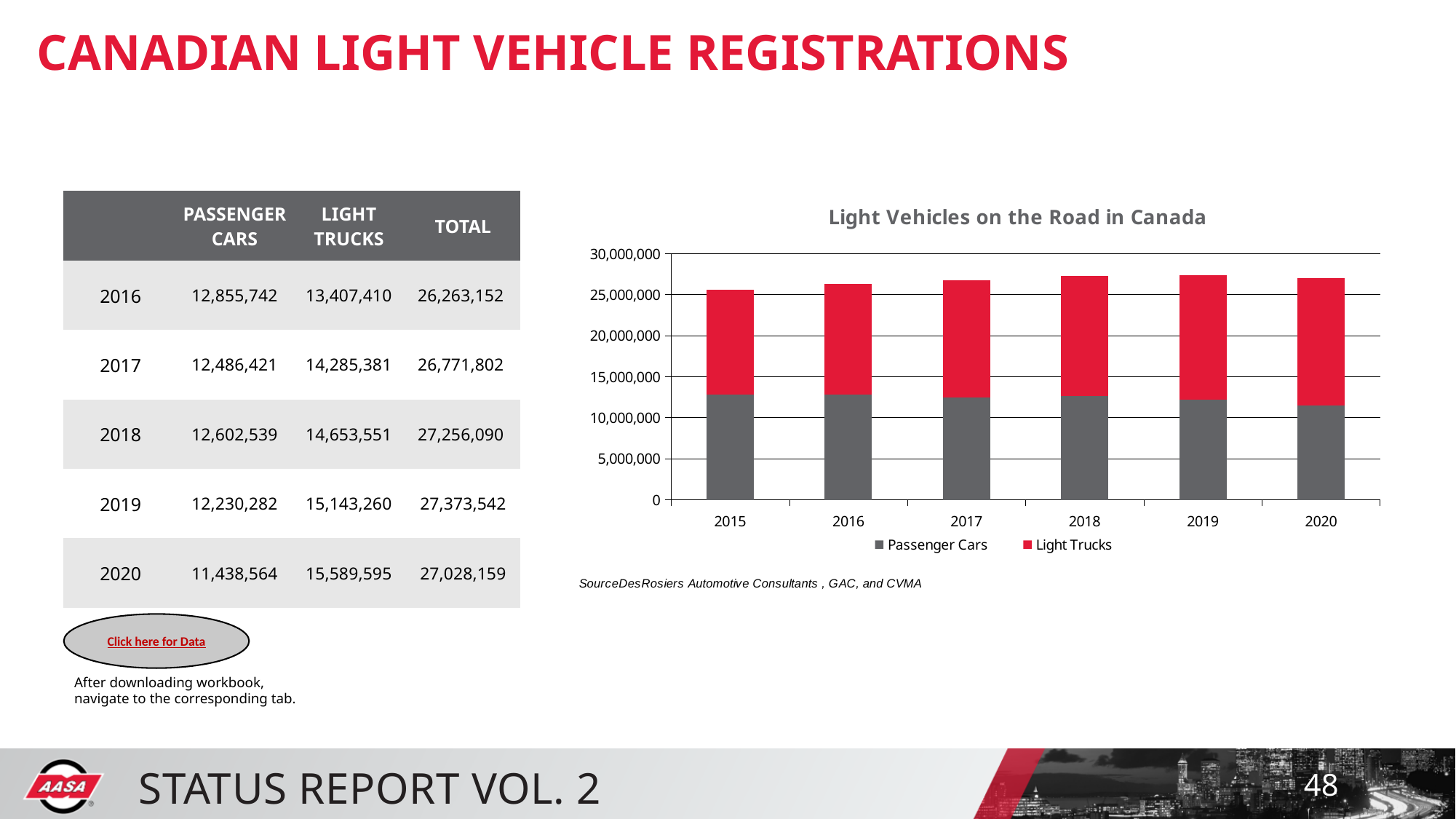
Do the Light Trucks values rise or fall from 2015 to 2020? rise What is the title of the chart on the slide? Light Vehicles on the Road in Canada Which colour represents Light Trucks in the chart? red In the chart, is the Passenger Cars value for 2020 greater or less than 10,000,000? greater How many series does the legend of the "Light Vehicles on the Road in Canada" chart list? 2 In the chart, is the Passenger Cars value for 2015 greater or less than 15,000,000? less How many years are shown on the x axis of the "Light Vehicles on the Road in Canada" chart? 6 Do the Passenger Cars values rise or fall from 2016 to 2020? fall According to the slide, what is the Light Trucks value for 2020? 15,589,595 What kind of chart is "Light Vehicles on the Road in Canada"? bar chart According to the slide, what is the total of the stacked bar for 2019 (Passenger Cars plus Light Trucks)? 27,373,542 According to the slide, what is the difference between Light Trucks and Passenger Cars in 2020? 4,151,031